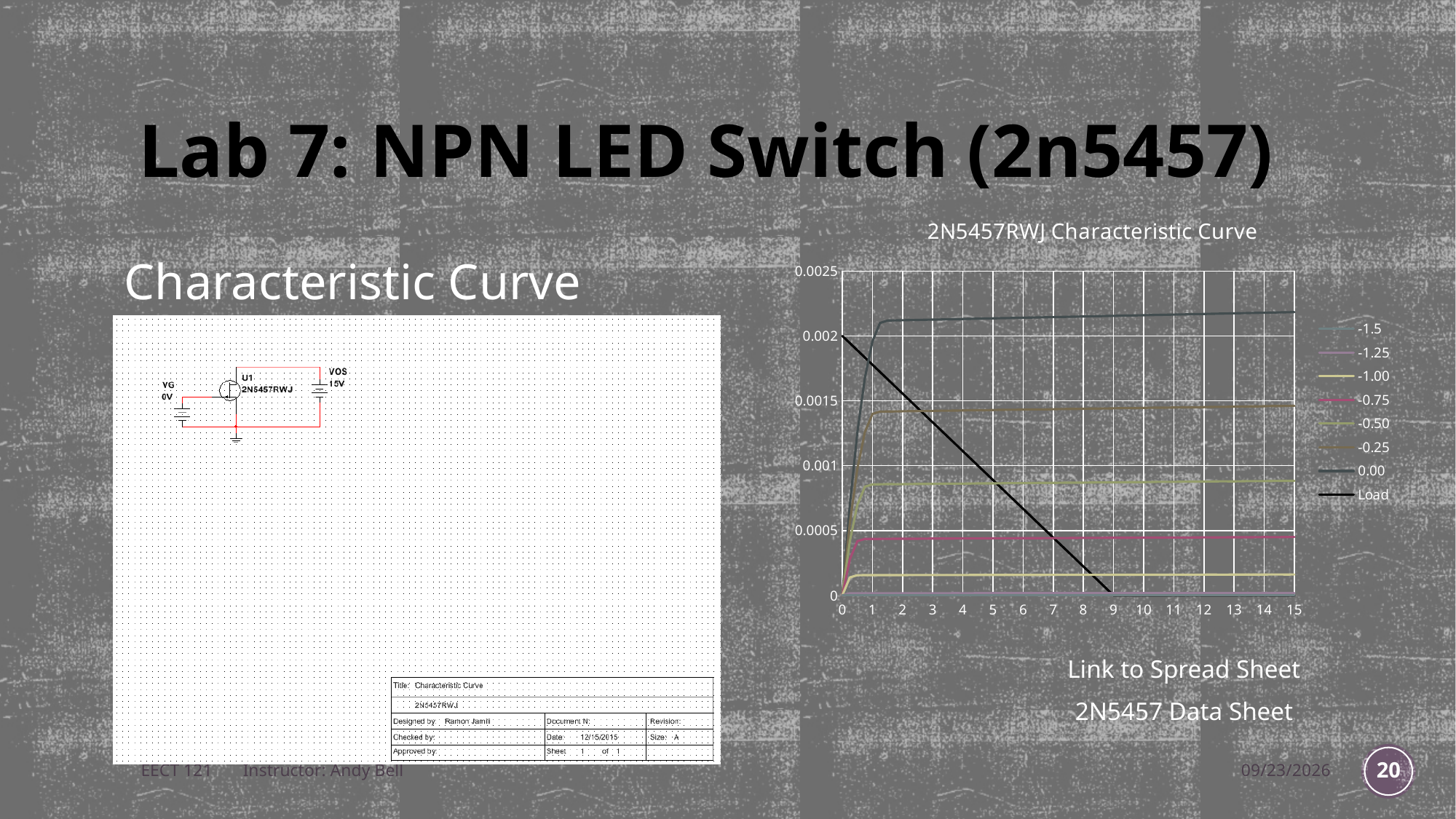
In the 2N5457RWJ Characteristic Curve chart, at x = 10, which series has the larger value: 0.00 or -0.25? 0.00 In the 2N5457RWJ Characteristic Curve chart, is the value of the -0.50 series at x = 10 greater or less than 0.001? less What kind of chart is the 2N5457RWJ Characteristic Curve chart? line chart What is the title of the chart on the slide? 2N5457RWJ Characteristic Curve What is the highest value labelled on the y axis of the 2N5457RWJ Characteristic Curve chart? 0.0025 In the 2N5457RWJ Characteristic Curve chart, is the value of the 0.00 series at x = 15 greater or less than 0.002? greater How many series does the legend of the 2N5457RWJ Characteristic Curve chart list? 8 In the 2N5457RWJ Characteristic Curve chart, which series reaches the highest values on the right side of the chart? 0.00 In the 2N5457RWJ Characteristic Curve chart, does the Load series rise or fall as x increases? fall In the 2N5457RWJ Characteristic Curve chart, is the value of the -0.25 series at x = 10 greater or less than 0.0015? less